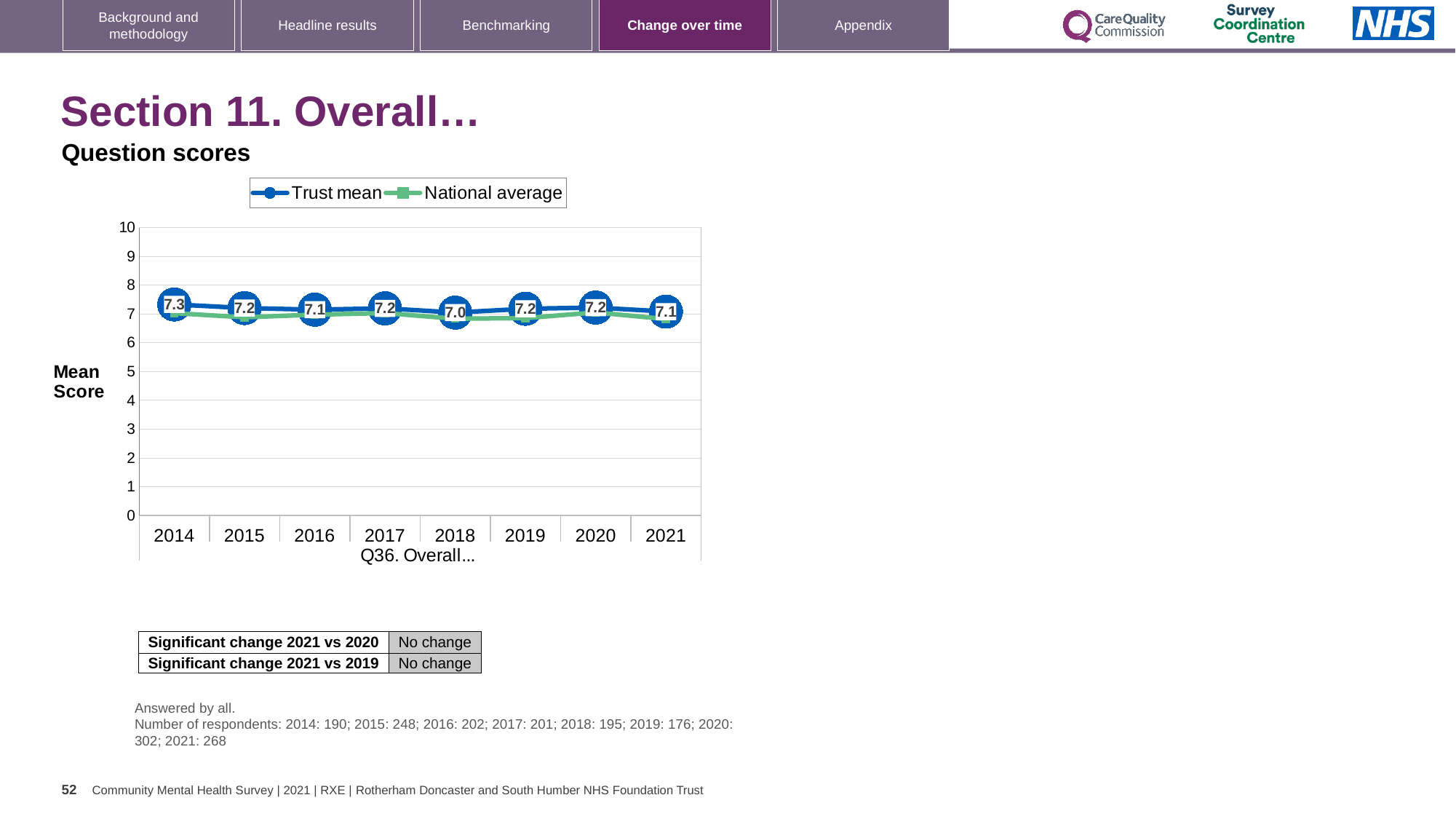
In which year is the Trust mean lowest? 2018 What is the Trust mean value for 2014? 7.3 Which is larger, the Trust mean in 2014 or in 2021? 2014 What is the Trust mean value for 2021? 7.1 What is the difference between the Trust mean in 2014 and in 2018? 0.3 What kind of chart is shown on the slide? Line chart Is the National average value for 2021 greater or less than 5? greater How many series does the legend list? 2 How many years are shown on the x axis? 8 What is the Trust mean value for 2020? 7.2 In which year is the Trust mean highest? 2014 What is the Trust mean value for 2018? 7.0